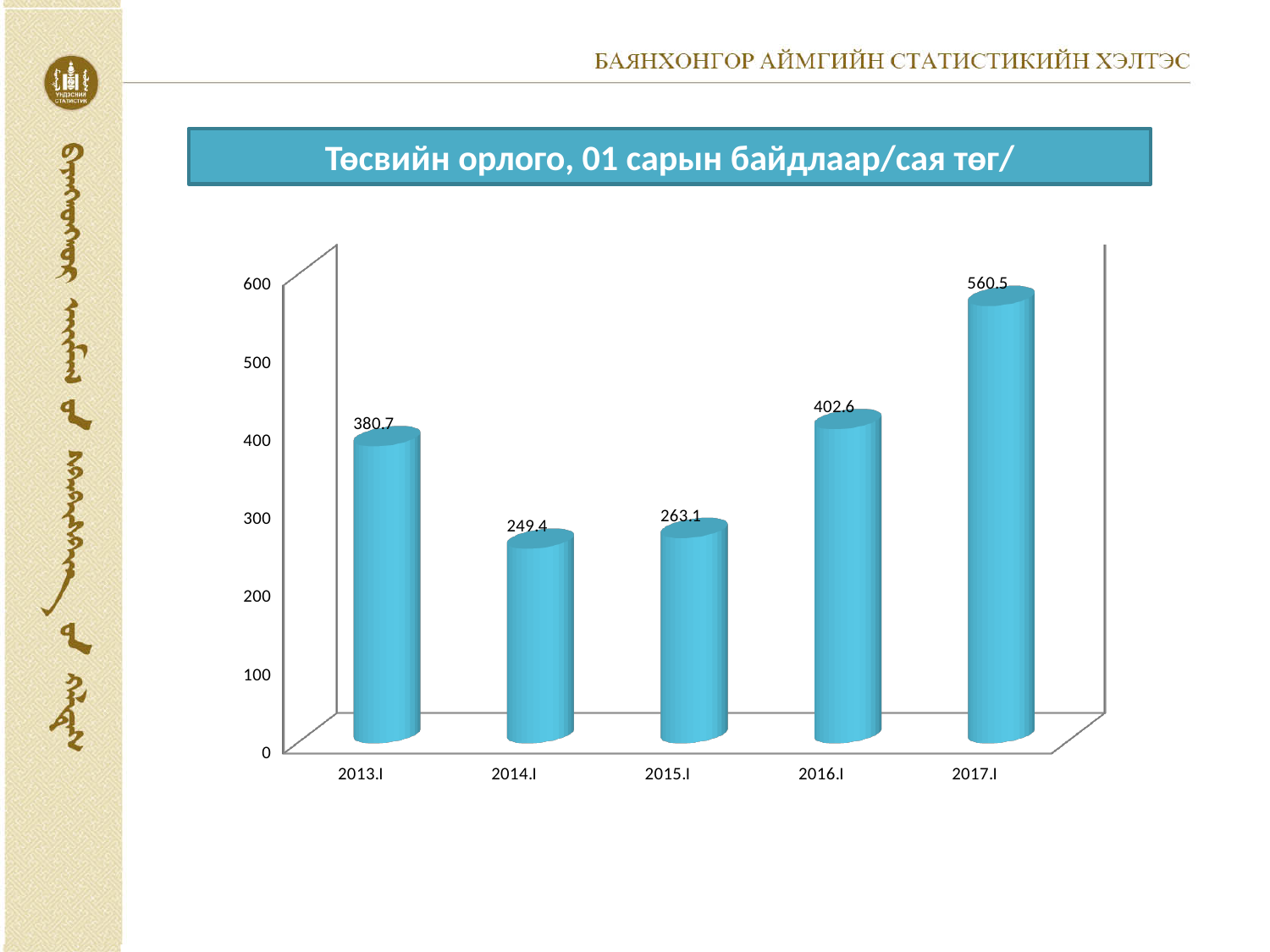
What is the value for 2016.I? 402.6 How many categories are shown on the x axis? 5 What is the value for 2015.I? 263.1 What is the difference between the values for 2017.I and 2016.I? 157.9 What is the value for 2017.I? 560.5 What is the value for 2013.I? 380.7 Which is larger, the value for 2013.I or the value for 2016.I? 2016.I What kind of chart is shown on the slide? bar chart Which category has the lowest value? 2014.I Which category has the highest value? 2017.I What is the value for 2014.I? 249.4 Is the value for 2015.I greater or less than 300? less